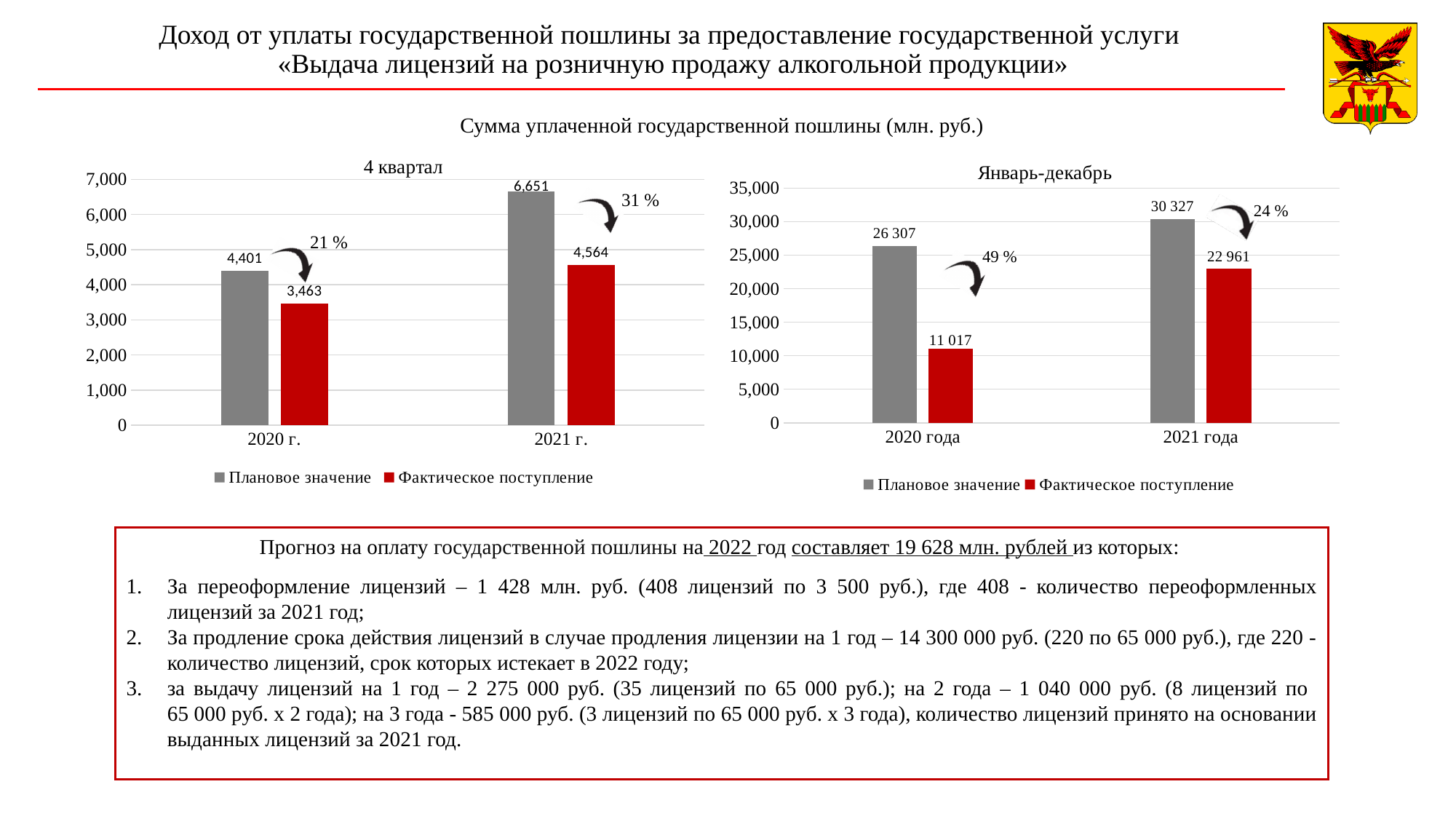
How many series does the legend of the "4 квартал" chart list? 2 In the "4 квартал" chart, what is the value of "Плановое значение" for 2020 г.? 4,401 In the "Январь-декабрь" chart, what is the value of "Плановое значение" for 2021 года? 30 327 In the "Январь-декабрь" chart, which bar is the lowest? Фактическое поступление, 2020 года In the "4 квартал" chart, which bar is the highest? Плановое значение, 2021 г. In the "Январь-декабрь" chart, what is the difference between "Плановое значение" and "Фактическое поступление" for 2021 года? 7 366 In the "4 квартал" chart, which colour represents "Фактическое поступление"? Red In the "Январь-декабрь" chart, which is larger: "Фактическое поступление" for 2020 года or for 2021 года? 2021 года In the "Январь-декабрь" chart, what is the value of "Фактическое поступление" for 2020 года? 11 017 In the "4 квартал" chart, what is the difference between "Плановое значение" and "Фактическое поступление" for 2020 г.? 938 What type of chart is the "Январь-декабрь" chart? Bar chart In the "4 квартал" chart, what is the value of "Фактическое поступление" for 2021 г.? 4,564